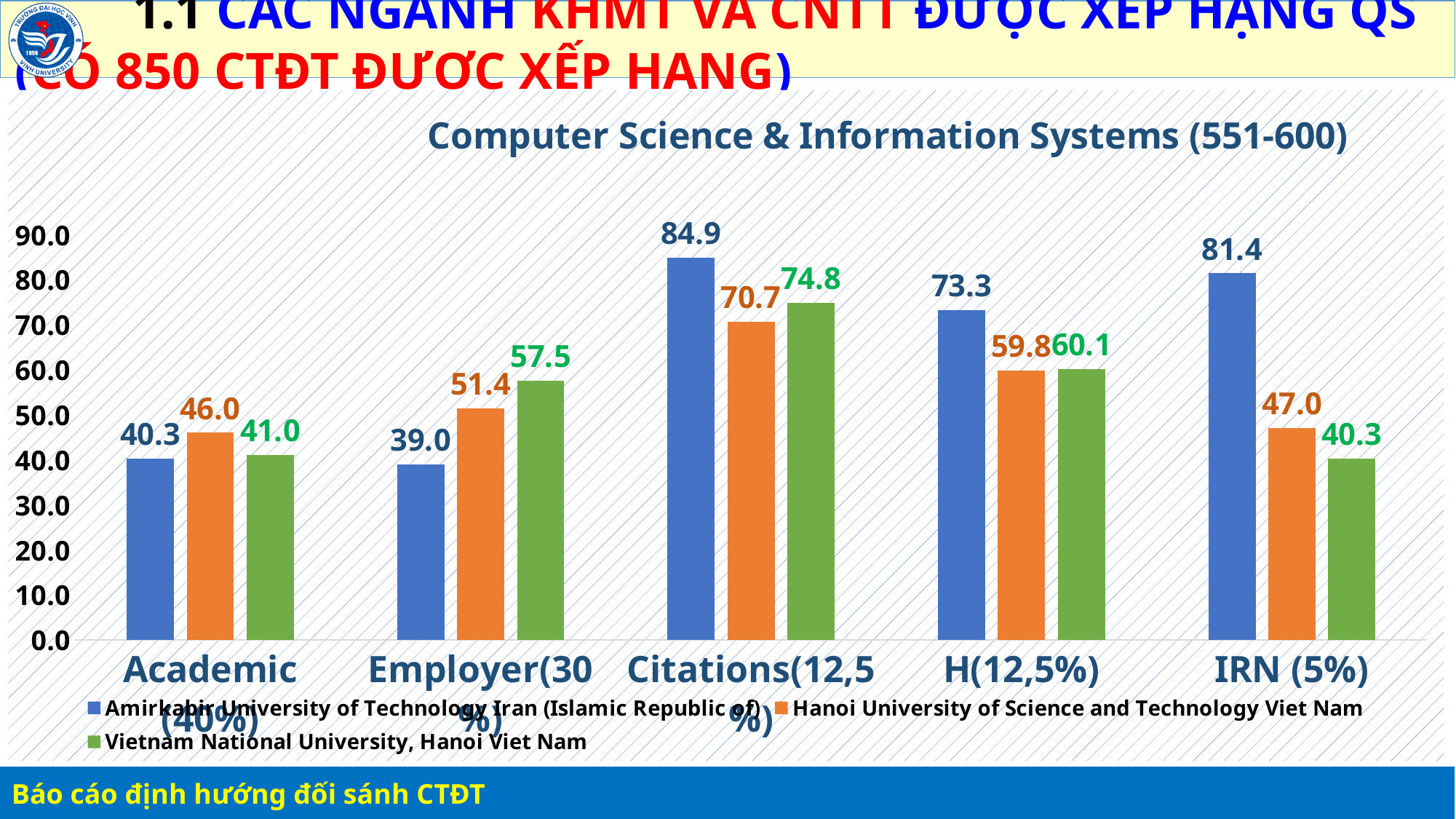
In the Employer (30%) category, which is larger: Hanoi University of Science and Technology or Vietnam National University, Hanoi? Vietnam National University, Hanoi Is the value for Amirkabir University of Technology in the H(12,5%) category greater or less than 70.0? greater What kind of chart is shown on the slide? bar chart In which category does Amirkabir University of Technology have its lowest value? Employer (30%) How many series does the legend list? 3 What is the value for Vietnam National University, Hanoi in the Employer (30%) category? 57.5 In which category does Amirkabir University of Technology have its highest value? Citations (12,5%) What is the title of the chart? Computer Science & Information Systems (551-600) What is the value for Amirkabir University of Technology in the Citations (12,5%) category? 84.9 What is the value for Hanoi University of Science and Technology in the IRN (5%) category? 47.0 What is the difference between Amirkabir University of Technology and Hanoi University of Science and Technology in the IRN (5%) category? 34.4 How many categories are shown on the x axis? 5